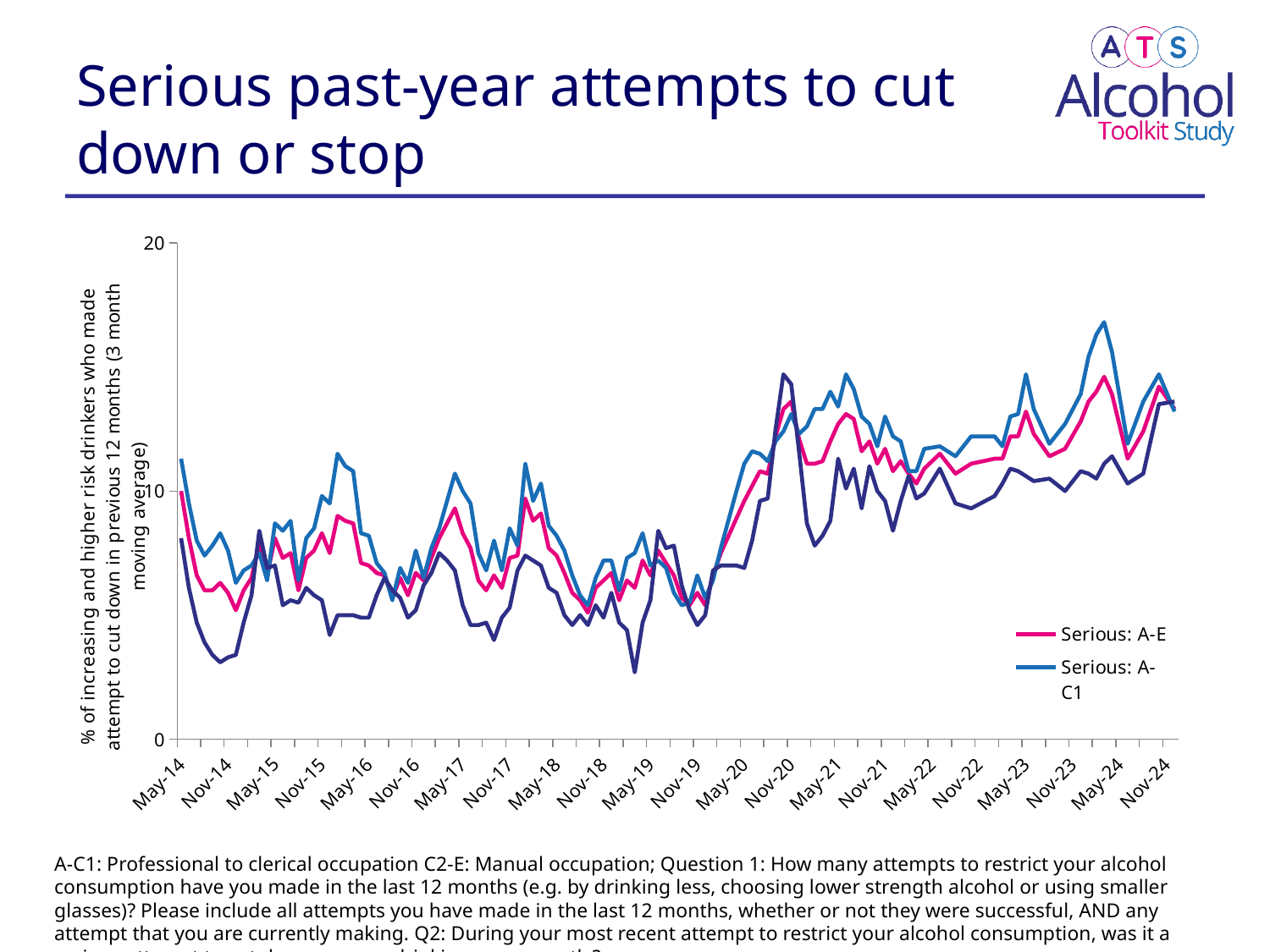
Is the value for Serious: A-C1 at May-14 greater or less than 10? greater What is the highest value shown on the y axis of the chart? 20 Is the value for Serious: A-E at Nov-14 greater or less than 10? less Is the value for Serious: A-E at Nov-18 greater or less than 10? less At May-24, which series has the higher value, Serious: A-E or Serious: A-C1? Serious: A-C1 How many date labels are shown along the x axis of the chart? 22 What are the two series named in the chart legend? Serious: A-E and Serious: A-C1 How many series does the chart legend list? 2 What kind of chart is shown on the slide? Line chart Between May-19 and Nov-20, do the values for Serious: A-E generally rise or fall? rise